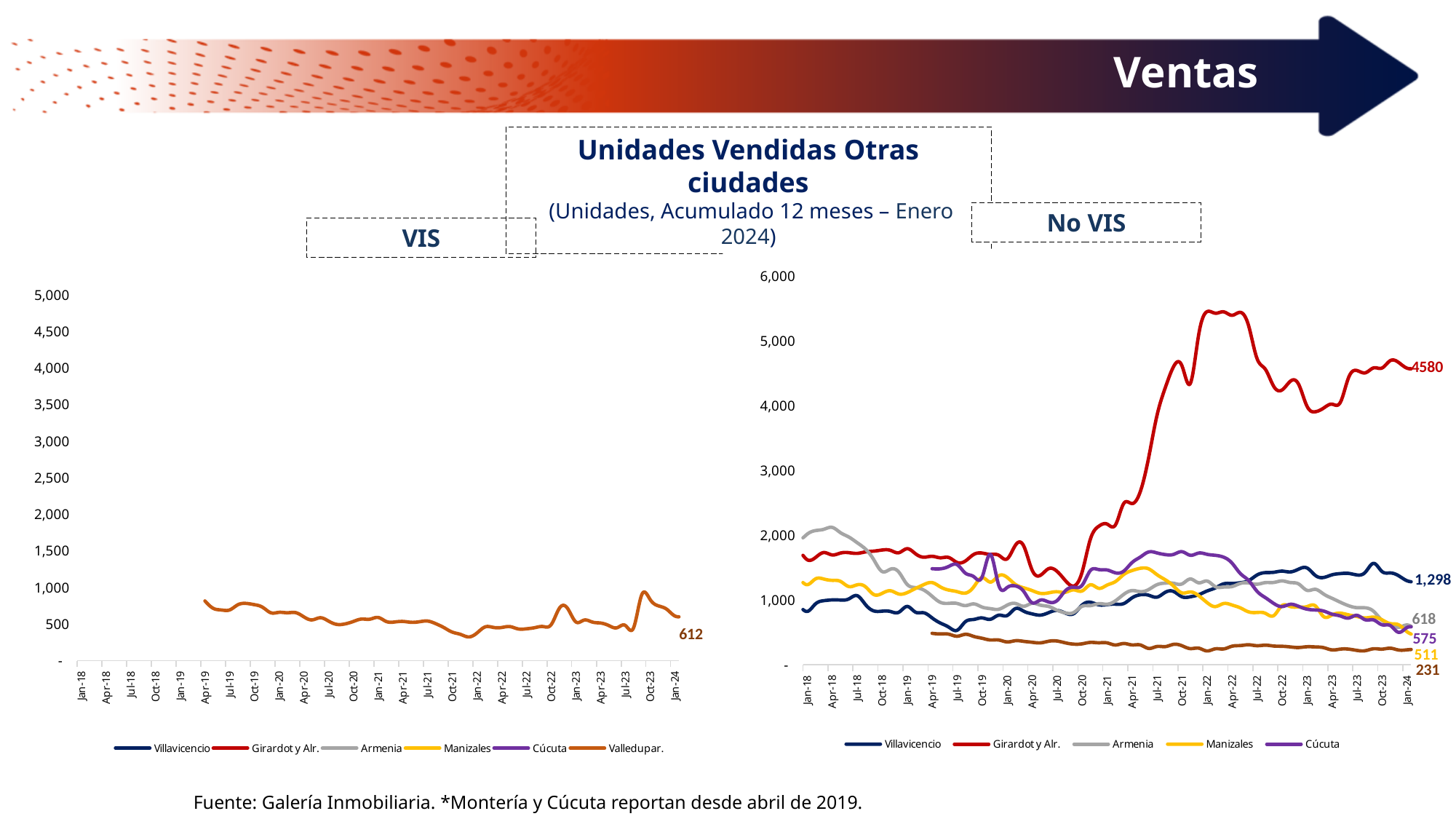
In the No VIS chart, what is the final labelled value for Cúcuta? 575 In the No VIS chart, which is larger at Jan-24: Cúcuta or Manizales? Cúcuta In the No VIS chart, what is the final labelled value for Manizales? 511 In the No VIS chart, what is the final labelled value for Girardot y Alr.? 4580 In the No VIS chart, is the value for Girardot y Alr. at Jan-18 greater or less than 2,000? less In the No VIS chart, what is the final labelled value for Armenia? 618 In the No VIS chart, which series has the highest value at Jan-24? Girardot y Alr. How many series does the legend of the No VIS chart list? 5 In the No VIS chart, what is the difference between the final values of Villavicencio and Armenia? 680 What kind of chart is the VIS chart on the left? Line chart In the VIS chart, what is the final labelled value for Valledupar? 612 In the No VIS chart, what is the final labelled value for Villavicencio? 1,298